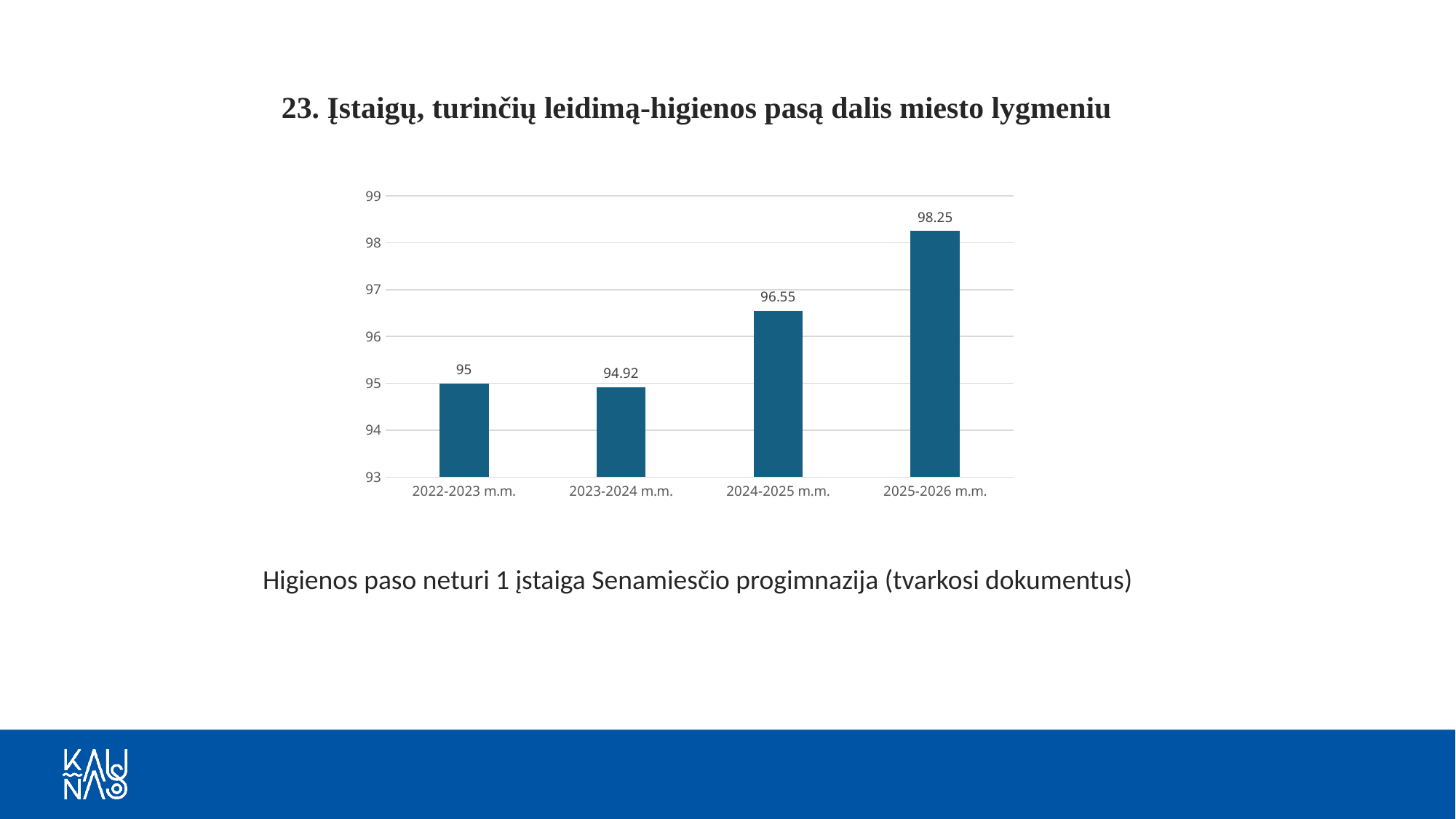
What is the value for 2023-2024 m.m.? 94.92 What is the value for 2022-2023 m.m.? 95 How many school years are shown on the x axis? 4 Which school year has the lowest value? 2023-2024 m.m. What is the difference between the values for 2025-2026 m.m. and 2024-2025 m.m.? 1.7 What kind of chart is shown on the slide? bar chart What is the title of the chart? 23. Įstaigų, turinčių leidimą-higienos pasą dalis miesto lygmeniu What is the value for 2024-2025 m.m.? 96.55 Which is larger, the value for 2024-2025 m.m. or the value for 2022-2023 m.m.? 2024-2025 m.m. Is the value for 2025-2026 m.m. greater or less than 98? greater What is the value for 2025-2026 m.m.? 98.25 Which school year has the highest value? 2025-2026 m.m.